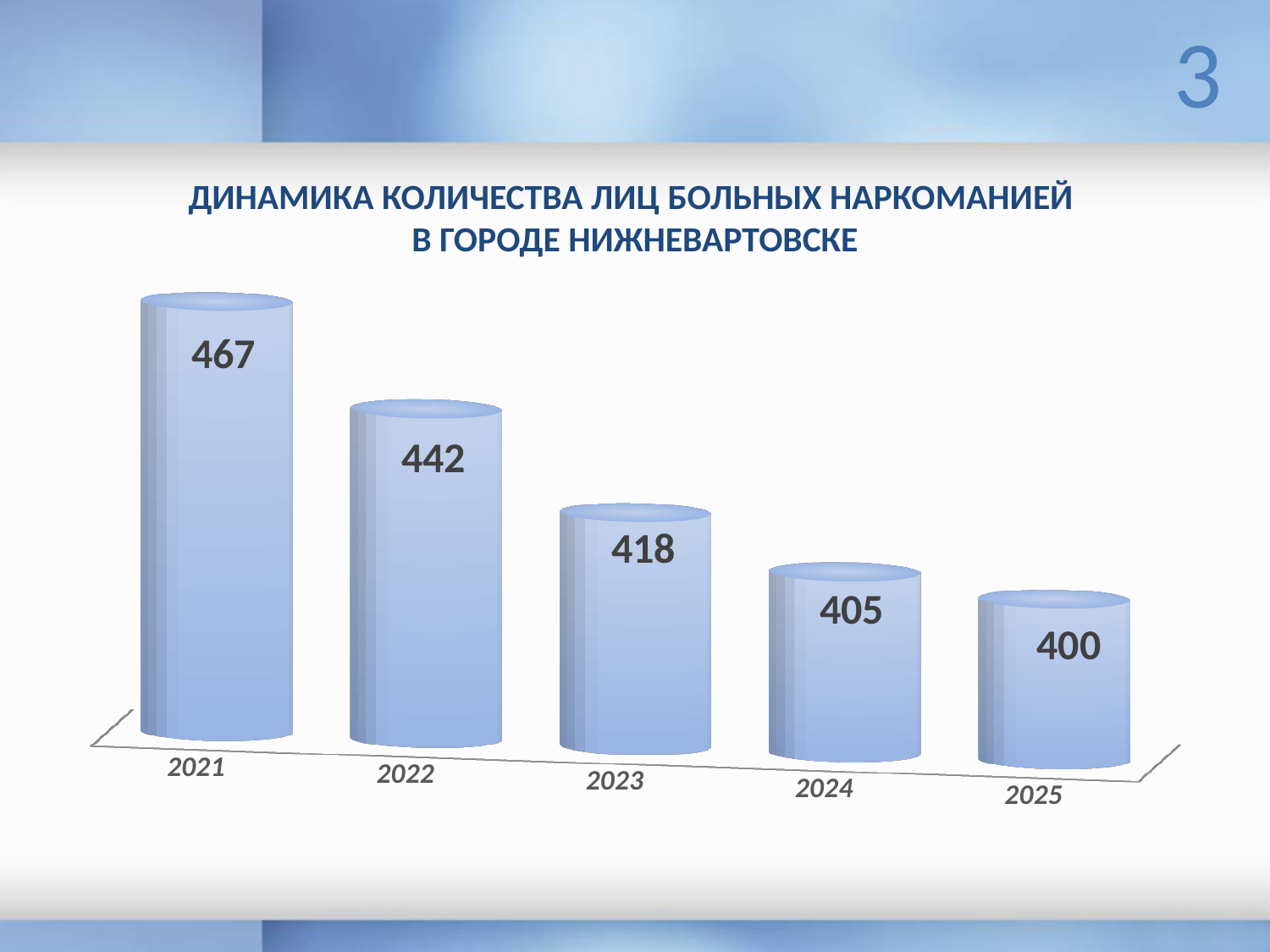
Which is larger, the value for 2022 or the value for 2023? 2022 Do the values rise or fall from 2021 to 2025? Fall What is the value for 2023? 418 How many years are shown on the chart? 5 What is the difference between the values for 2024 and 2025? 5 What is the title of the chart? ДИНАМИКА КОЛИЧЕСТВА ЛИЦ БОЛЬНЫХ НАРКОМАНИЕЙ В ГОРОДЕ НИЖНЕВАРТОВСКЕ What is the value for 2021? 467 What is the value for 2025? 400 Which year has the lowest value? 2025 What is the difference between the values for 2021 and 2022? 25 Which year has the highest value? 2021 What kind of chart is shown on the slide? Bar chart